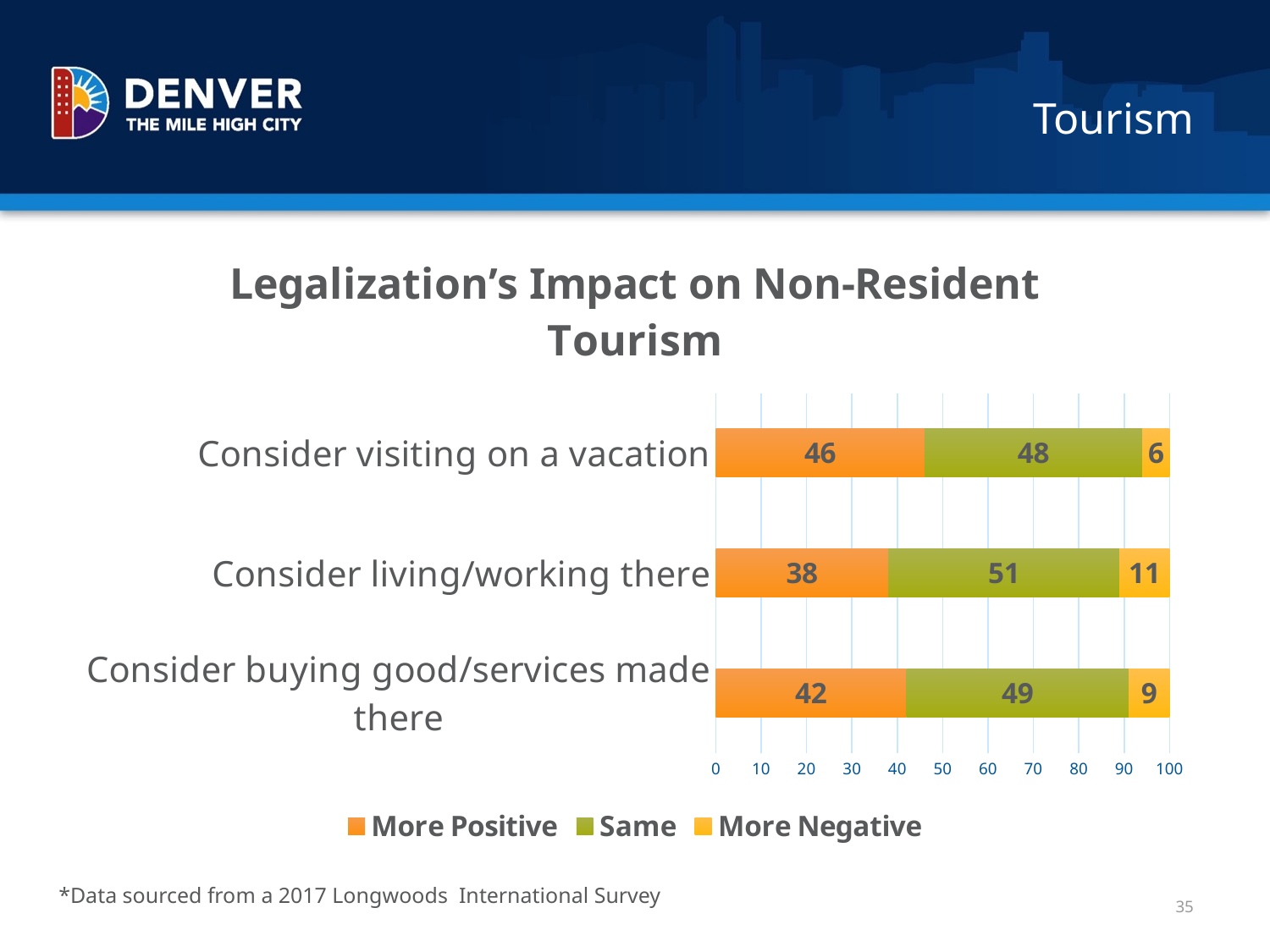
What is the difference between the 'More Positive' values for 'Consider visiting on a vacation' and 'Consider living/working there'? 8 How many categories are shown on the chart? 3 What kind of chart is shown on the slide? Stacked bar chart What is the 'Same' value for 'Consider living/working there'? 51 What is the title of the chart? Legalization's Impact on Non-Resident Tourism Which category has the highest 'More Positive' value? Consider visiting on a vacation Which is larger: the 'More Negative' value for 'Consider living/working there' or for 'Consider buying good/services made there'? Consider living/working there Which category has the lowest 'More Negative' value? Consider visiting on a vacation What is the 'More Positive' value for 'Consider visiting on a vacation'? 46 What is the 'More Negative' value for 'Consider buying good/services made there'? 9 What is the total of the stacked bar for 'Consider living/working there'? 100 How many series does the legend list? 3